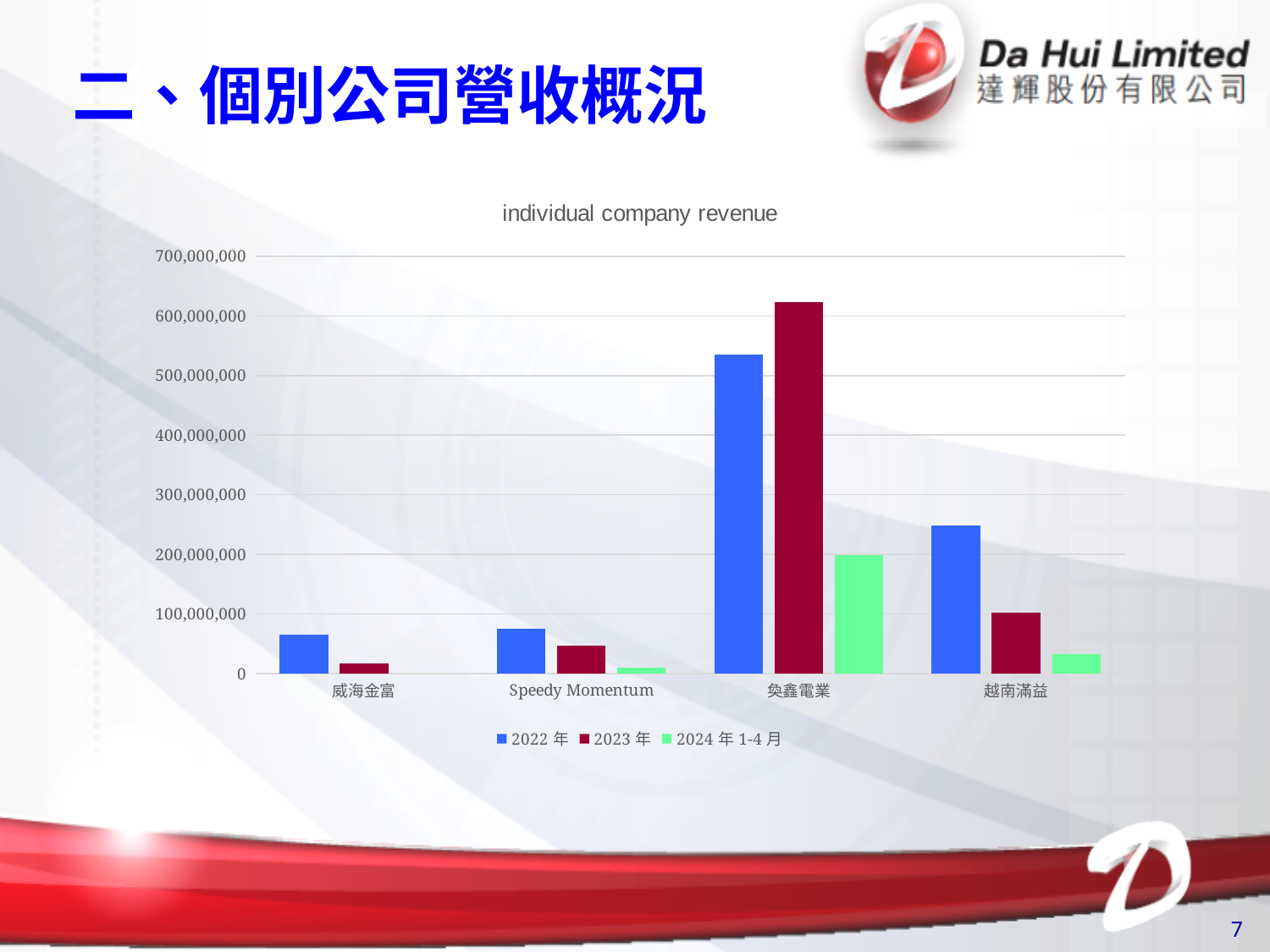
What kind of chart is shown on the slide? bar chart How many companies are shown on the x axis of the chart? 4 For 越南滿益, which is larger: the 2022 年 value or the 2023 年 value? 2022 年 Is the 2023 年 value for 奐鑫電業 greater or less than 600,000,000? greater Is the 2022 年 value for 奐鑫電業 greater or less than 500,000,000? greater For 奐鑫電業, which is larger: the 2022 年 value or the 2023 年 value? 2023 年 Is the 2022 年 value for 威海金富 greater or less than 100,000,000? less Which company has the highest 2023 年 revenue in the chart? 奐鑫電業 Which company has the lowest 2023 年 revenue in the chart? 威海金富 What is the title of the chart? individual company revenue How many series does the chart's legend list? 3